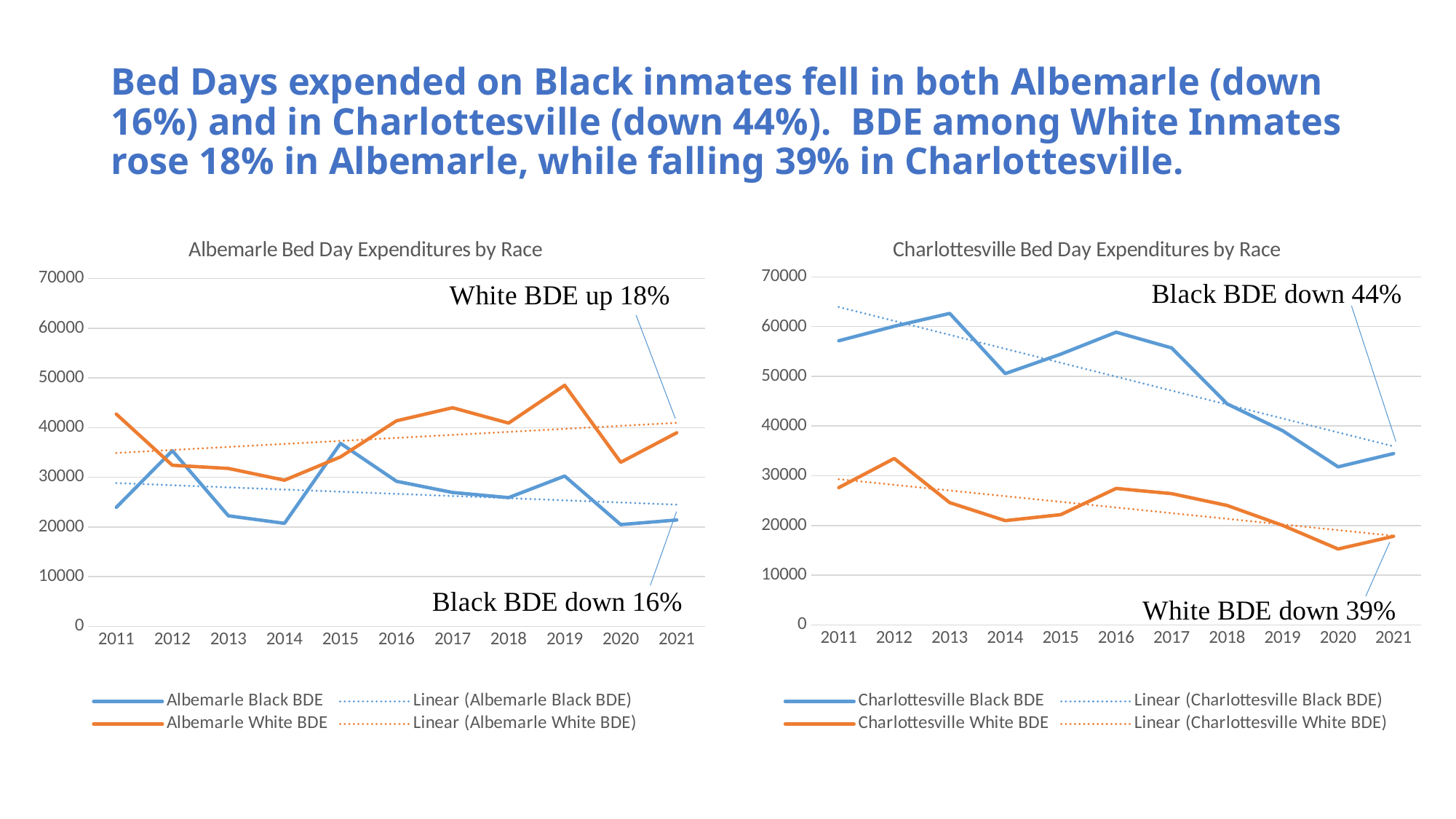
In the Charlottesville Bed Day Expenditures by Race chart, in which year is Charlottesville Black BDE highest? 2013 How many years are shown on the x axis of the Charlottesville Bed Day Expenditures by Race chart? 11 In the Charlottesville Bed Day Expenditures by Race chart, is the Charlottesville White BDE value for 2020 greater or less than 20000? less How many entries does the legend of the Albemarle Bed Day Expenditures by Race chart list? 4 In the Charlottesville Bed Day Expenditures by Race chart, in which year is Charlottesville White BDE lowest? 2020 What is the title of the chart on the right side of the slide? Charlottesville Bed Day Expenditures by Race In the Albemarle Bed Day Expenditures by Race chart, in which year is Albemarle White BDE highest? 2019 In the Charlottesville Bed Day Expenditures by Race chart, is the Charlottesville Black BDE value for 2011 greater or less than 50000? greater In the Charlottesville Bed Day Expenditures by Race chart, does Charlottesville Black BDE generally rise or fall from 2011 to 2021? fall What kind of chart is the Albemarle Bed Day Expenditures by Race chart? line chart In the Albemarle Bed Day Expenditures by Race chart, which is larger in 2011: Albemarle Black BDE or Albemarle White BDE? Albemarle White BDE In the Albemarle Bed Day Expenditures by Race chart, is the Albemarle White BDE value for 2019 greater or less than 40000? greater